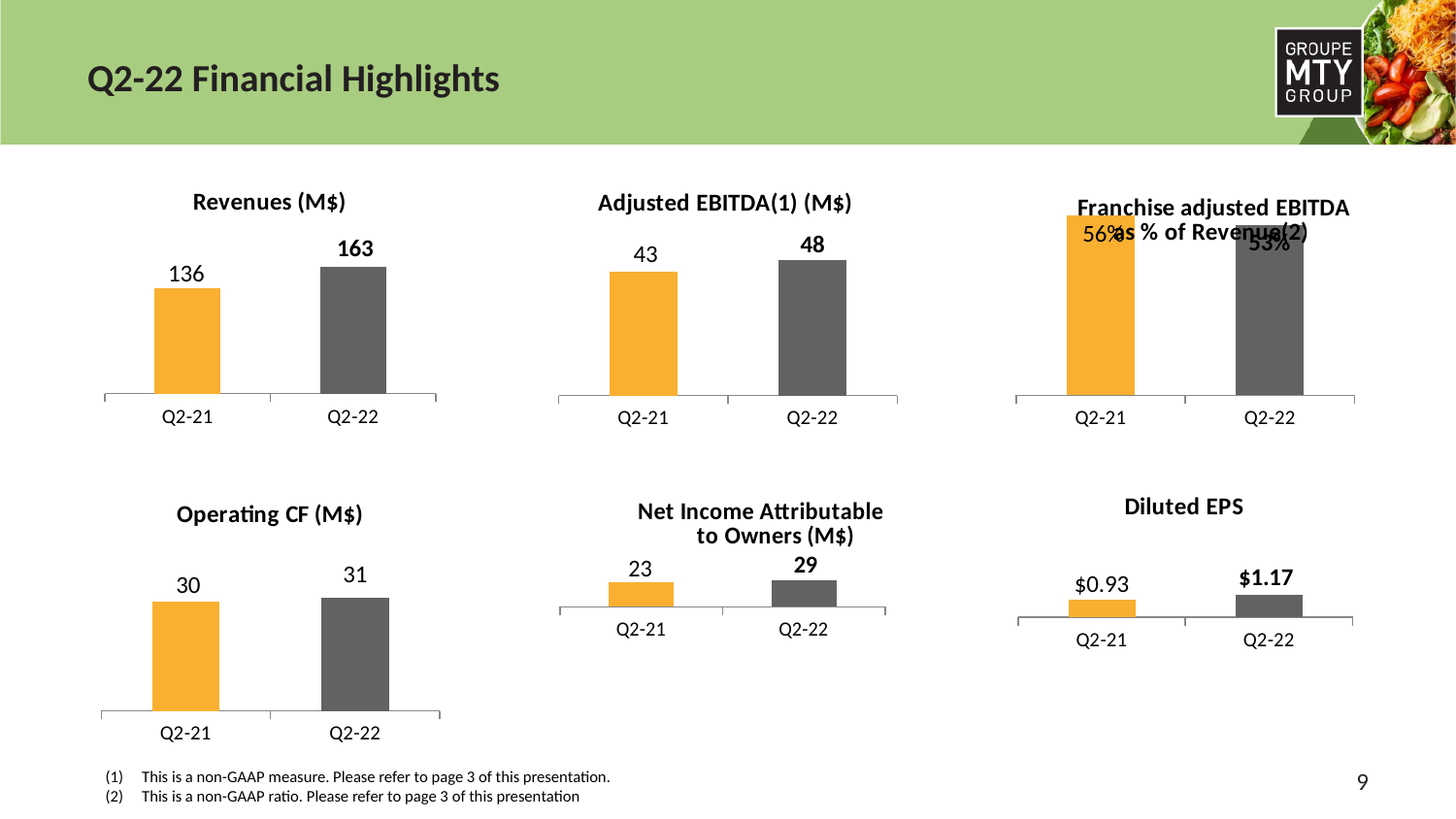
In the Revenues (M$) chart, what is the difference between Q2-22 and Q2-21? 27 How many categories does the Operating CF (M$) chart show? 2 In the Adjusted EBITDA(1) (M$) chart, which quarter has the higher value? Q2-22 In the Diluted EPS chart, what is the value for Q2-21? $0.93 What type of chart is the Revenues (M$) chart? bar chart In the Diluted EPS chart, what is the value for Q2-22? $1.17 In the Net Income Attributable to Owners (M$) chart, what is the difference between Q2-22 and Q2-21? 6 In the Revenues (M$) chart, what is the value for Q2-22? 163 In the Operating CF (M$) chart, what is the value for Q2-22? 31 In the Franchise adjusted EBITDA as % of Revenue(2) chart, is the value for Q2-21 larger or smaller than the value for Q2-22? larger In the Adjusted EBITDA(1) (M$) chart, what is the value for Q2-21? 43 In the Franchise adjusted EBITDA as % of Revenue(2) chart, what is the value for Q2-21? 56%